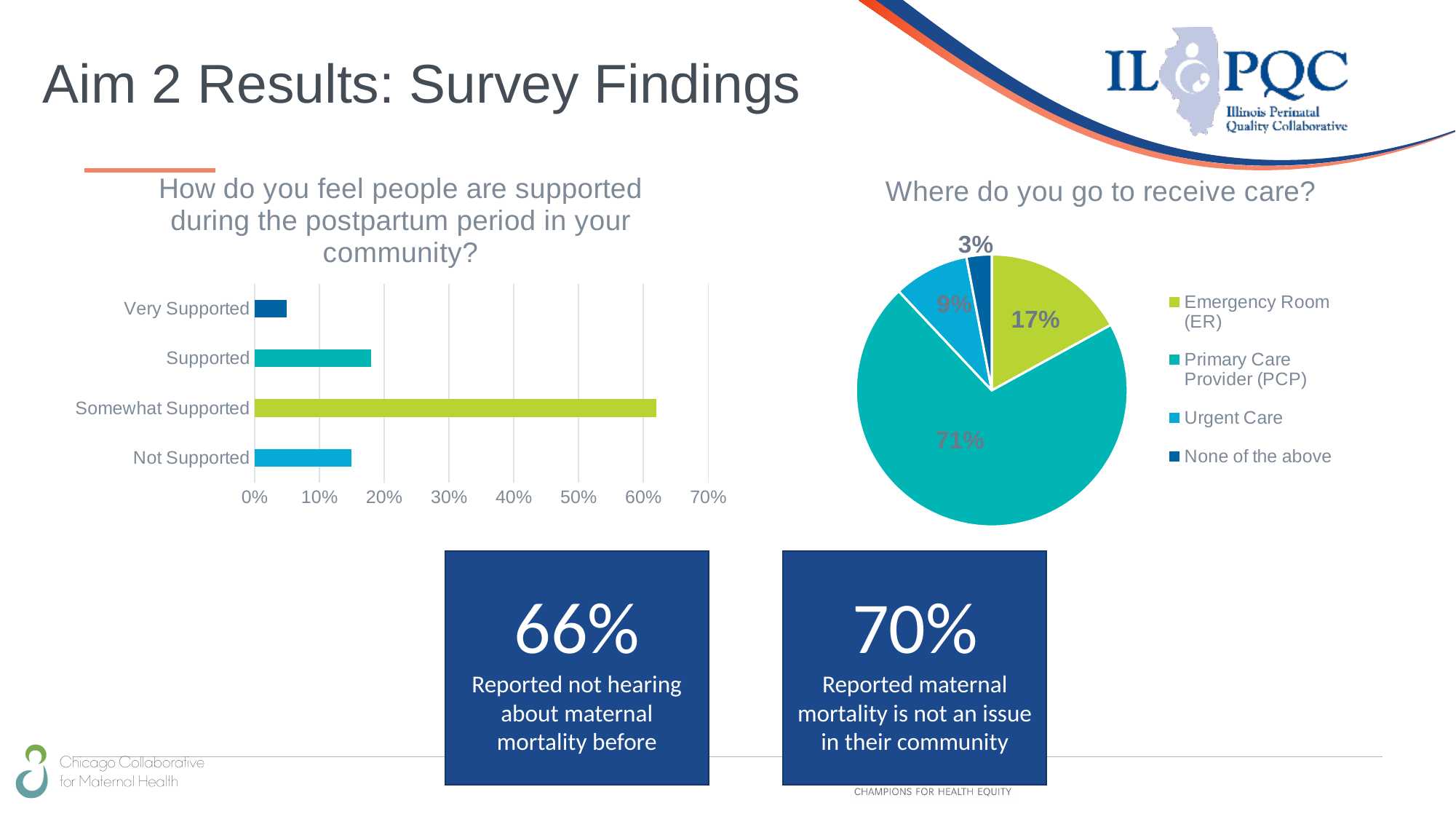
In the chart titled "How do you feel people are supported during the postpartum period in your community?", which category has the highest value? Somewhat Supported In the chart titled "How do you feel people are supported during the postpartum period in your community?", is the value for Very Supported greater or less than 10%? less In the pie chart titled "Where do you go to receive care?", what is the difference between the Primary Care Provider (PCP) share and the Emergency Room (ER) share? 54% In the chart titled "How do you feel people are supported during the postpartum period in your community?", which is larger: Supported or Not Supported? Supported What kind of chart is the one titled "How do you feel people are supported during the postpartum period in your community?" Bar chart In the chart titled "How do you feel people are supported during the postpartum period in your community?", which category has the lowest value? Very Supported How many categories does the legend of the pie chart titled "Where do you go to receive care?" list? 4 How many categories are shown in the chart titled "How do you feel people are supported during the postpartum period in your community?" 4 In the chart titled "How do you feel people are supported during the postpartum period in your community?", is the value for Somewhat Supported greater or less than 60%? greater In the pie chart titled "Where do you go to receive care?", what share goes to Primary Care Provider (PCP)? 71% In the pie chart titled "Where do you go to receive care?", which category has the smallest slice? None of the above In the pie chart titled "Where do you go to receive care?", what share goes to Emergency Room (ER)? 17%